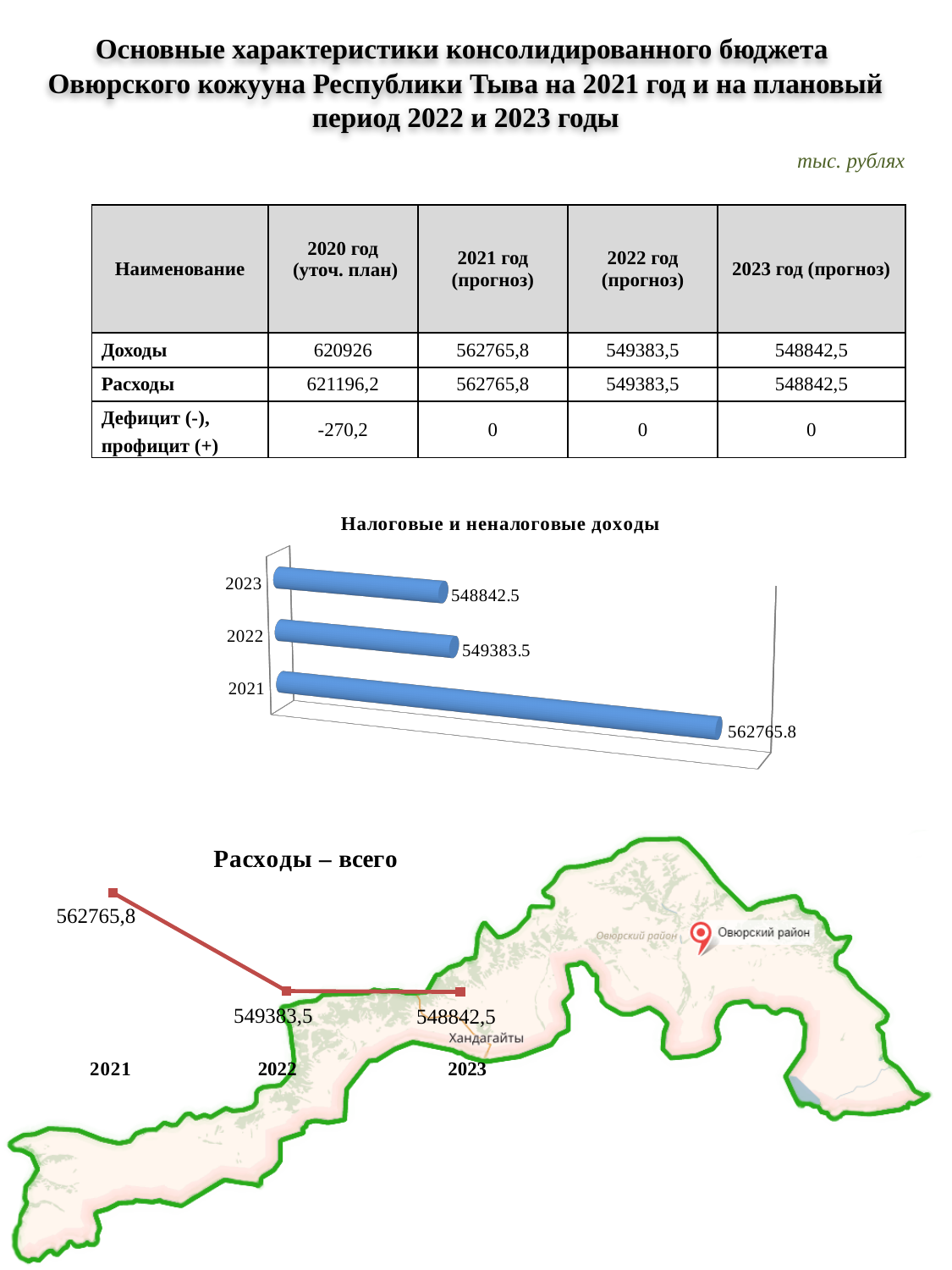
What kind of chart is the one titled "Налоговые и неналоговые доходы"? bar chart In the chart titled "Налоговые и неналоговые доходы", what is the value for 2021? 562765.8 In the chart titled "Расходы – всего", do the values rise or fall from 2021 to 2023? fall What kind of chart is the one titled "Расходы – всего"? line chart In the chart titled "Расходы – всего", what is the difference between the 2021 value and the 2023 value? 13923,3 In the chart titled "Расходы – всего", what is the value for 2022? 549383,5 In the chart titled "Налоговые и неналоговые доходы", how many bars are plotted? 3 In the chart titled "Налоговые и неналоговые доходы", what is the value for 2023? 548842.5 In the chart titled "Налоговые и неналоговые доходы", which year has the highest value? 2021 In the chart titled "Расходы – всего", what is the value for 2023? 548842,5 In the chart titled "Расходы – всего", which year has the lowest value? 2023 In the chart titled "Налоговые и неналоговые доходы", what is the difference between the 2021 value and the 2022 value? 13382.3